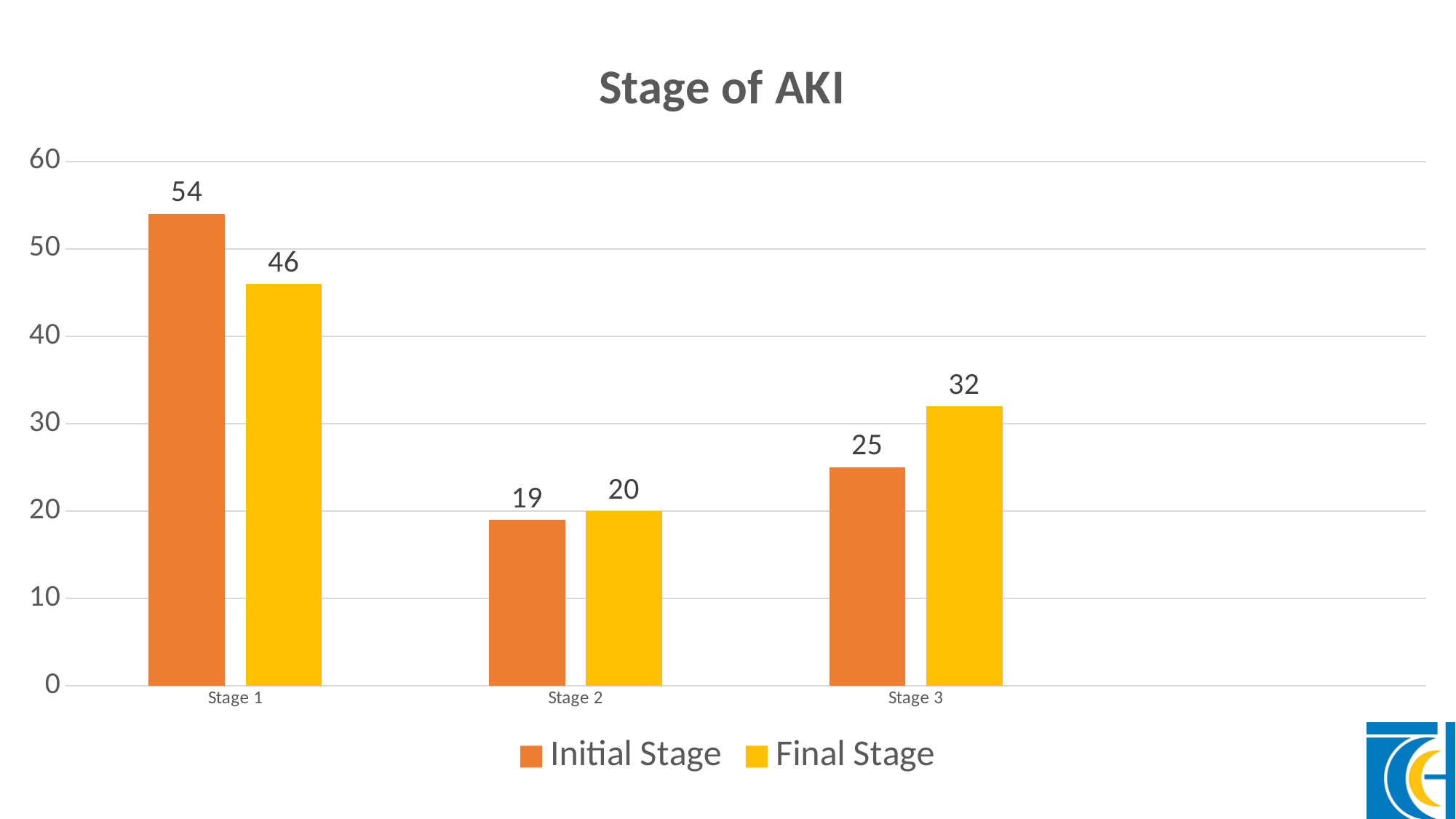
Which is larger for Stage 3, the Initial Stage value or the Final Stage value? Final Stage What is the Initial Stage value for Stage 1? 54 What is the difference between the Final Stage and Initial Stage values for Stage 3? 7 Which category has the lowest Final Stage value? Stage 2 What is the Final Stage value for Stage 2? 20 Is the Initial Stage value for Stage 2 greater or less than 20? less How many categories are shown on the x axis? 3 What kind of chart is shown on the slide? bar chart How many series does the legend list? 2 What is the Final Stage value for Stage 3? 32 Which category has the highest Initial Stage value? Stage 1 What is the difference between the Initial Stage and Final Stage values for Stage 1? 8